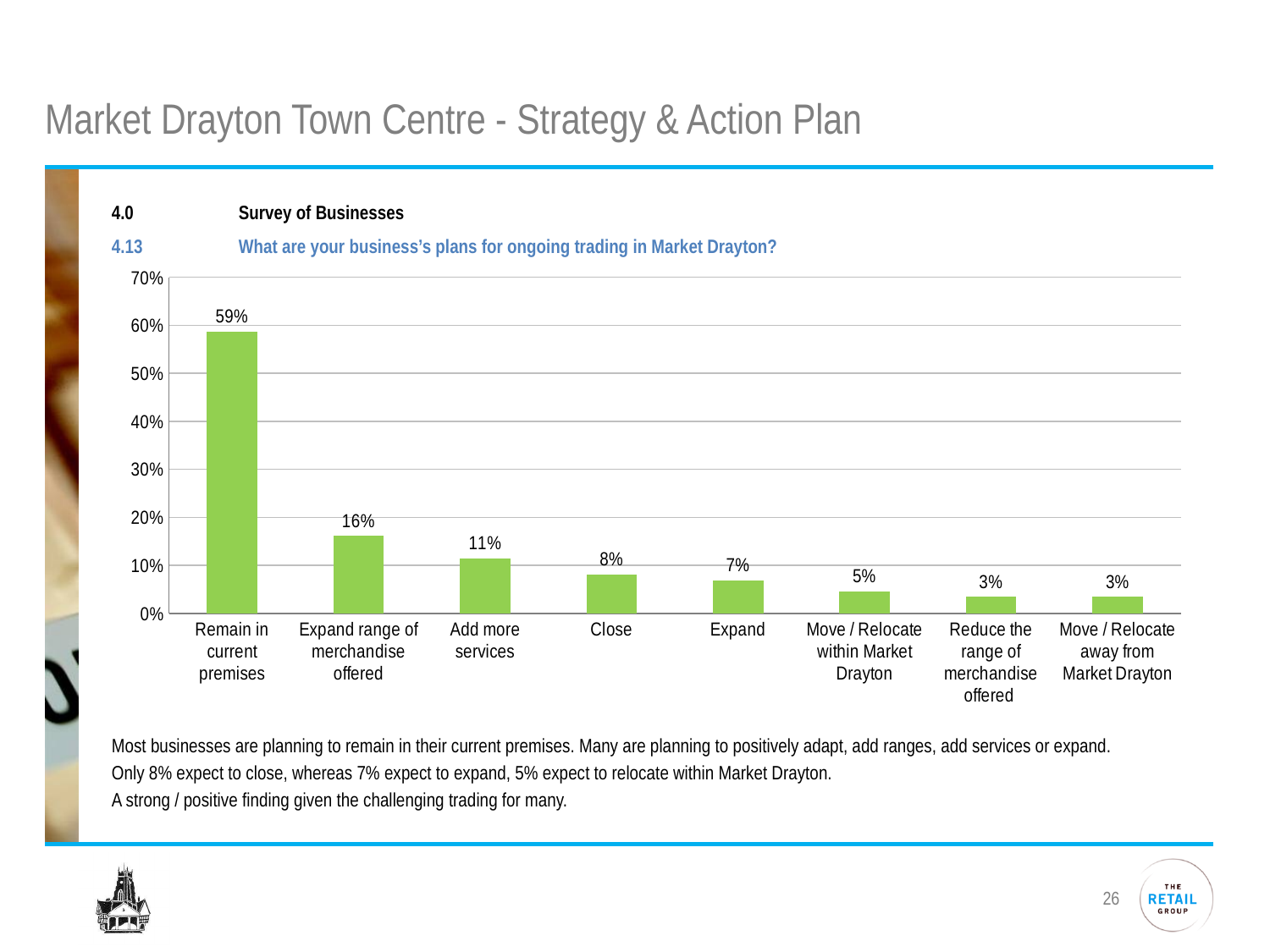
What is the highest value shown on the vertical axis? 70% What is the difference between 'Remain in current premises' and 'Expand range of merchandise offered'? 43% Which is larger, 'Add more services' or 'Close'? Add more services What percentage of businesses plan to remain in current premises? 59% What is the value for 'Expand range of merchandise offered'? 16% Is the value for 'Remain in current premises' greater or less than 50%? greater What percentage of businesses plan to close? 8% How many categories are shown on the chart? 8 What is the value for 'Move / Relocate within Market Drayton'? 5% What kind of chart is shown on the slide? Bar chart Which category has the highest value? Remain in current premises What is the difference between 'Close' and 'Expand'? 1%